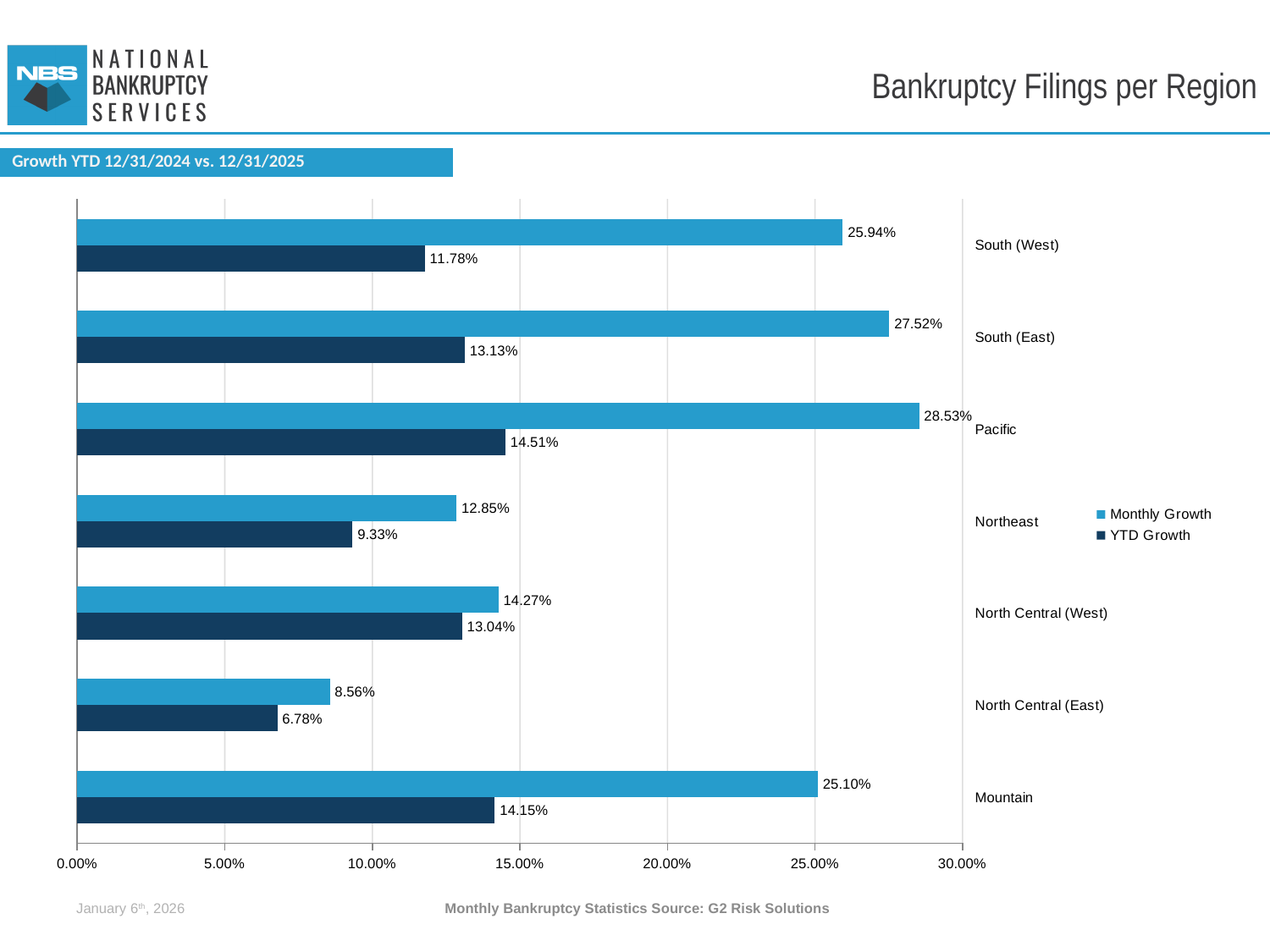
Is the Monthly Growth value for Northeast greater or less than 15.00%? less What kind of chart is shown on the slide? Bar chart Which is larger, the Monthly Growth for South (East) or the Monthly Growth for Mountain? South (East) What is the YTD Growth value for Mountain? 14.15% How many regions are shown on the chart? 7 What is the title shown above the chart? Growth YTD 12/31/2024 vs. 12/31/2025 What is the YTD Growth value for North Central (East)? 6.78% What is the Monthly Growth value for Pacific? 28.53% Which region has the lowest YTD Growth? North Central (East) How many series does the legend list? 2 What is the difference between Monthly Growth and YTD Growth for South (West)? 14.16% Which region has the highest Monthly Growth? Pacific